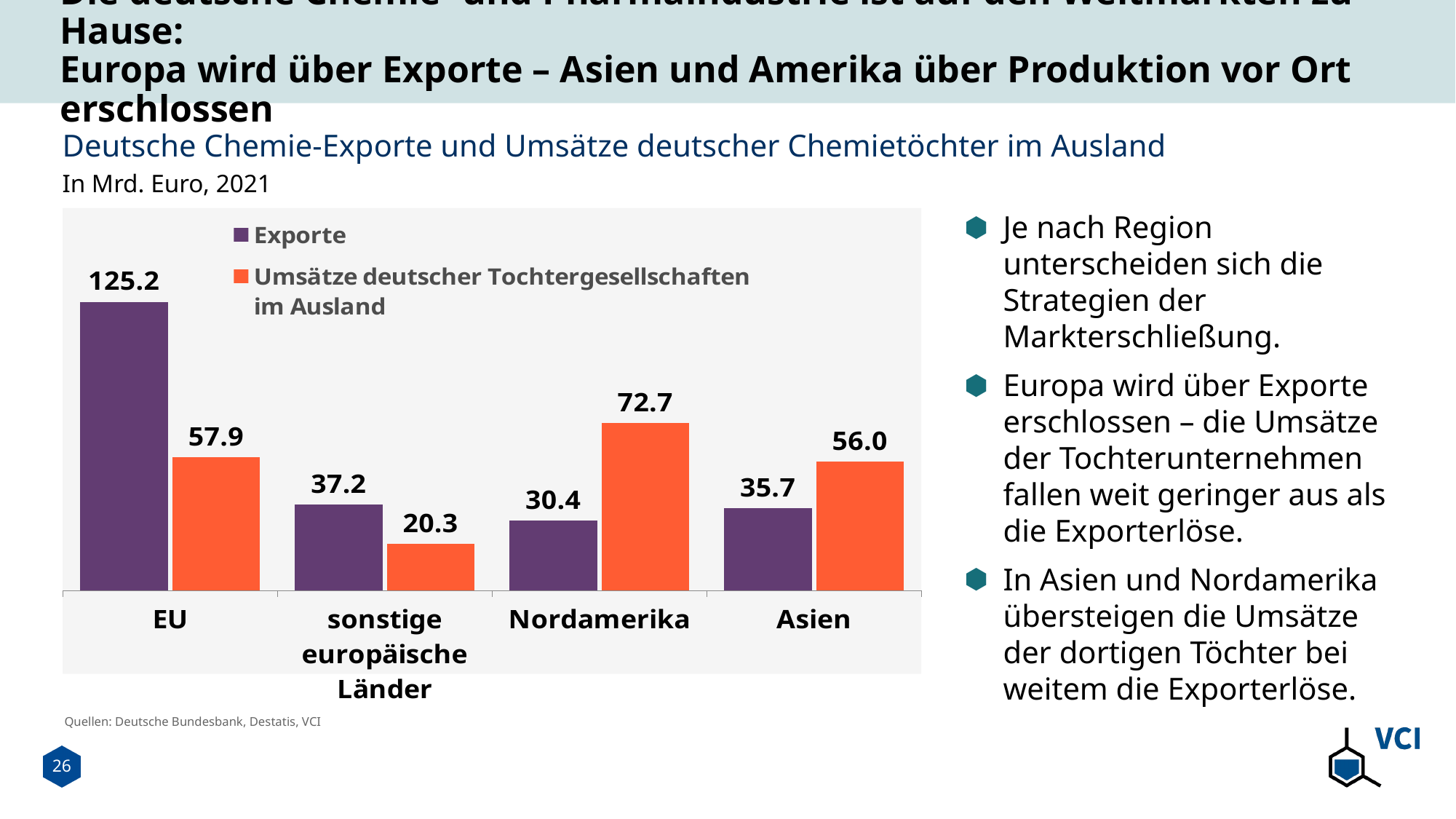
What is the Exporte value for Asien? 35.7 What is the value of Umsätze deutscher Tochtergesellschaften im Ausland for sonstige europäische Länder? 20.3 What unit and year are given for the chart's values? In Mrd. Euro, 2021 What is the Exporte value for EU? 125.2 What is the value of Umsätze deutscher Tochtergesellschaften im Ausland for Nordamerika? 72.7 For Asien, which is larger: Exporte or Umsätze deutscher Tochtergesellschaften im Ausland? Umsätze deutscher Tochtergesellschaften im Ausland Which region has the lowest value for Umsätze deutscher Tochtergesellschaften im Ausland? sonstige europäische Länder How many series does the legend list? 2 How many regions are shown on the x axis? 4 What kind of chart is shown? bar chart What is the difference between Exporte and Umsätze deutscher Tochtergesellschaften im Ausland for EU? 67.3 Which region has the highest Exporte value? EU